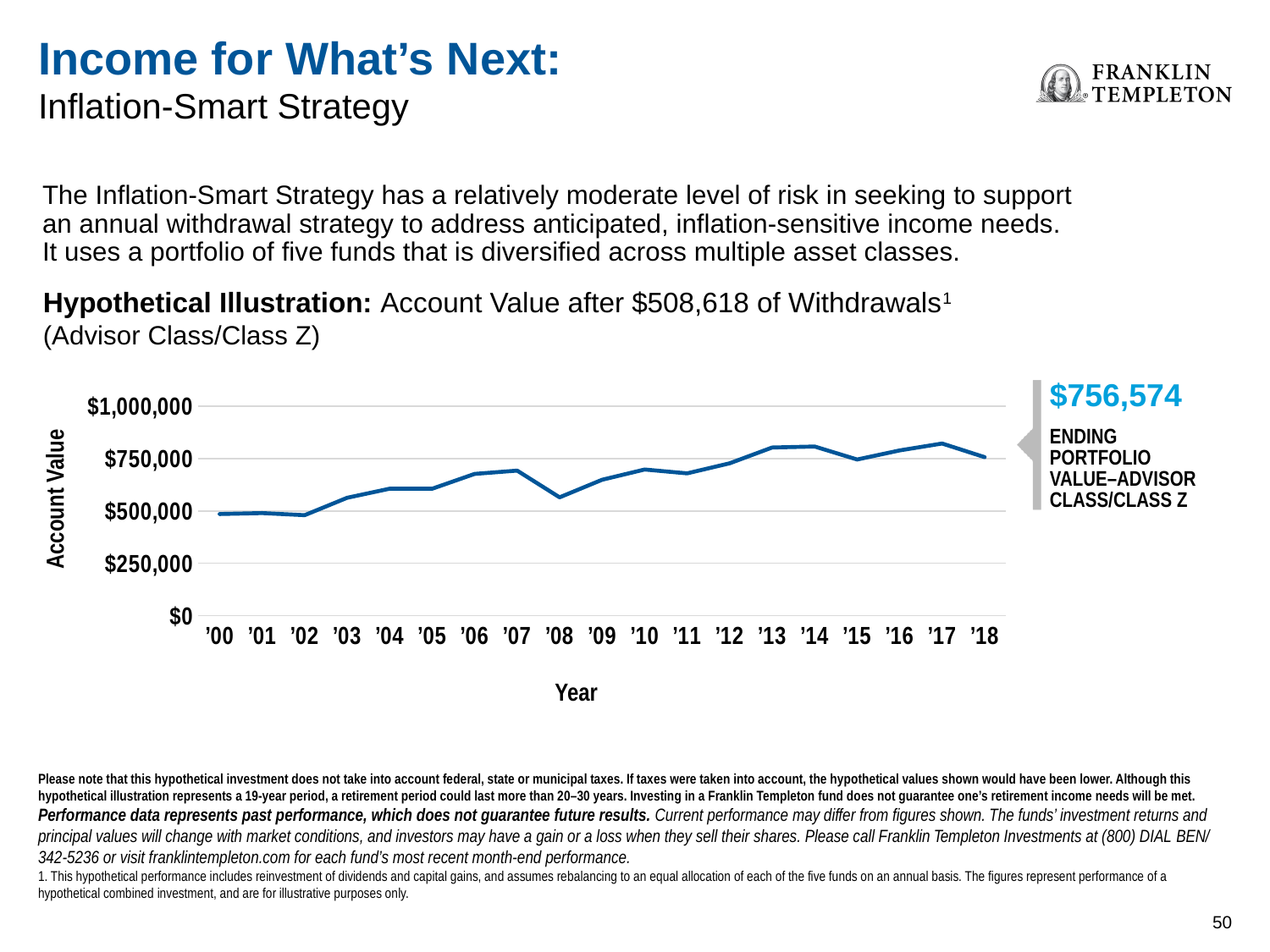
What is the title of the horizontal axis of the chart? Year What kind of chart is shown on the slide? line chart What is the title of the vertical axis of the chart? Account Value What is the ending portfolio value for Advisor Class/Class Z shown at the end of the line? $756,574 Is the account value for '05 greater or less than $750,000? less Is the account value for '08 greater or less than $500,000? greater How many years are plotted along the x axis of the chart? 19 Is the account value for '02 greater or less than $750,000? less Which year has the larger account value, '05 or '15? '15 Which year has the larger account value, '08 or '13? '13 Overall, does the account value rise or fall from '00 to '18? rise